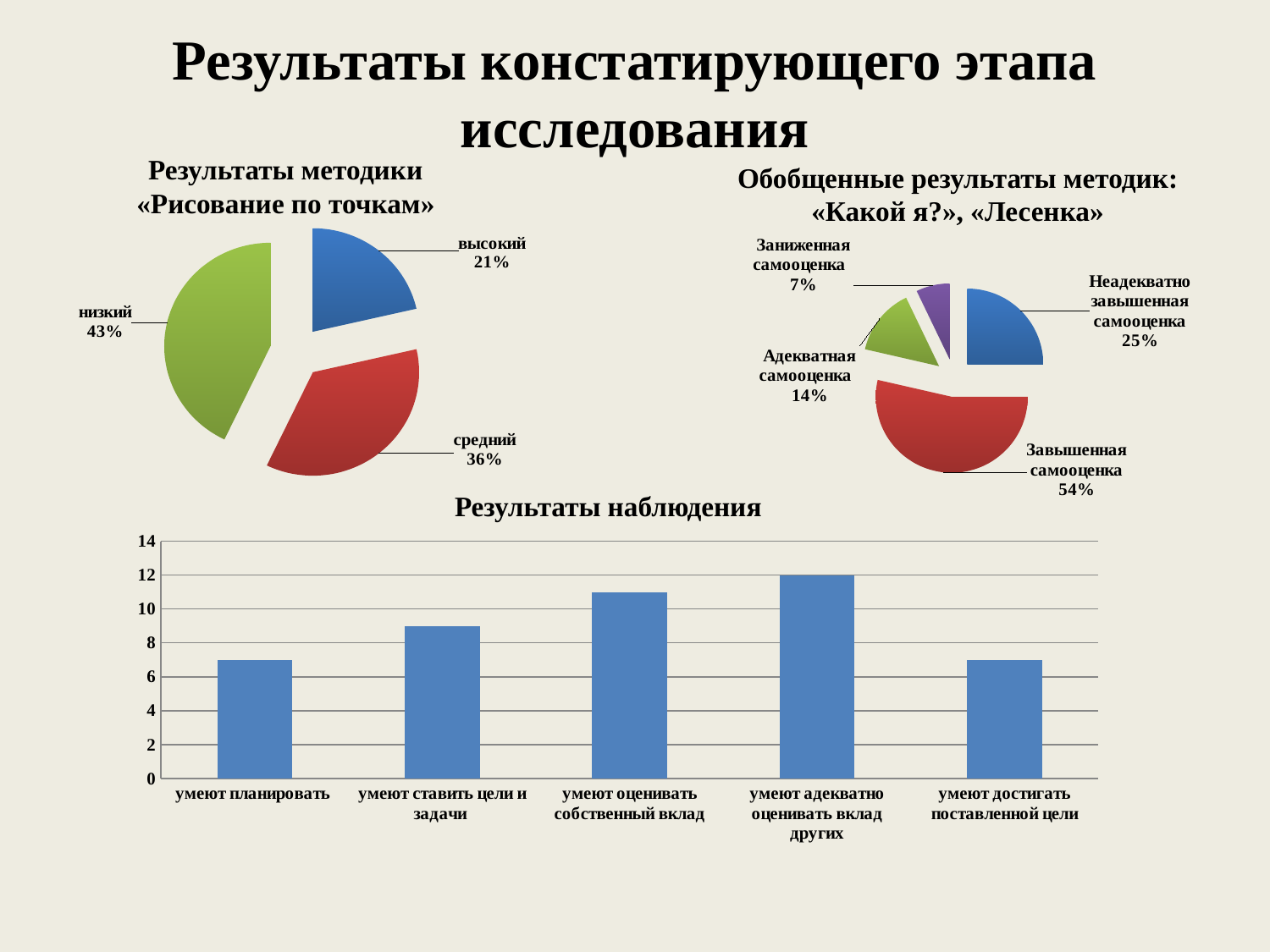
How many categories does the pie chart «Обобщенные результаты методик: «Какой я?», «Лесенка»» show? 4 In the chart «Результаты наблюдения», which category has the highest value? умеют адекватно оценивать вклад других In the pie chart «Результаты методики «Рисование по точкам»», what share is labelled «низкий»? 43% In the chart «Результаты наблюдения», what is the value for «умеют адекватно оценивать вклад других»? 12 In the pie chart «Обобщенные результаты методик: «Какой я?», «Лесенка»», what share is «Завышенная самооценка»? 54% In the pie chart «Обобщенные результаты методик: «Какой я?», «Лесенка»», which is larger: «Адекватная самооценка» or «Неадекватно завышенная самооценка»? Неадекватно завышенная самооценка In the pie chart «Обобщенные результаты методик: «Какой я?», «Лесенка»», which category has the smallest share? Заниженная самооценка How many slices does the pie chart «Результаты методики «Рисование по точкам»» have? 3 In the chart «Результаты наблюдения», is the value for «умеют ставить цели и задачи» greater or less than 8? greater In the pie chart «Результаты методики «Рисование по точкам»», what is the difference between the «низкий» and «средний» shares? 7% What kind of chart is «Результаты наблюдения»? bar chart In the pie chart «Результаты методики «Рисование по точкам»», which category has the smallest share? высокий